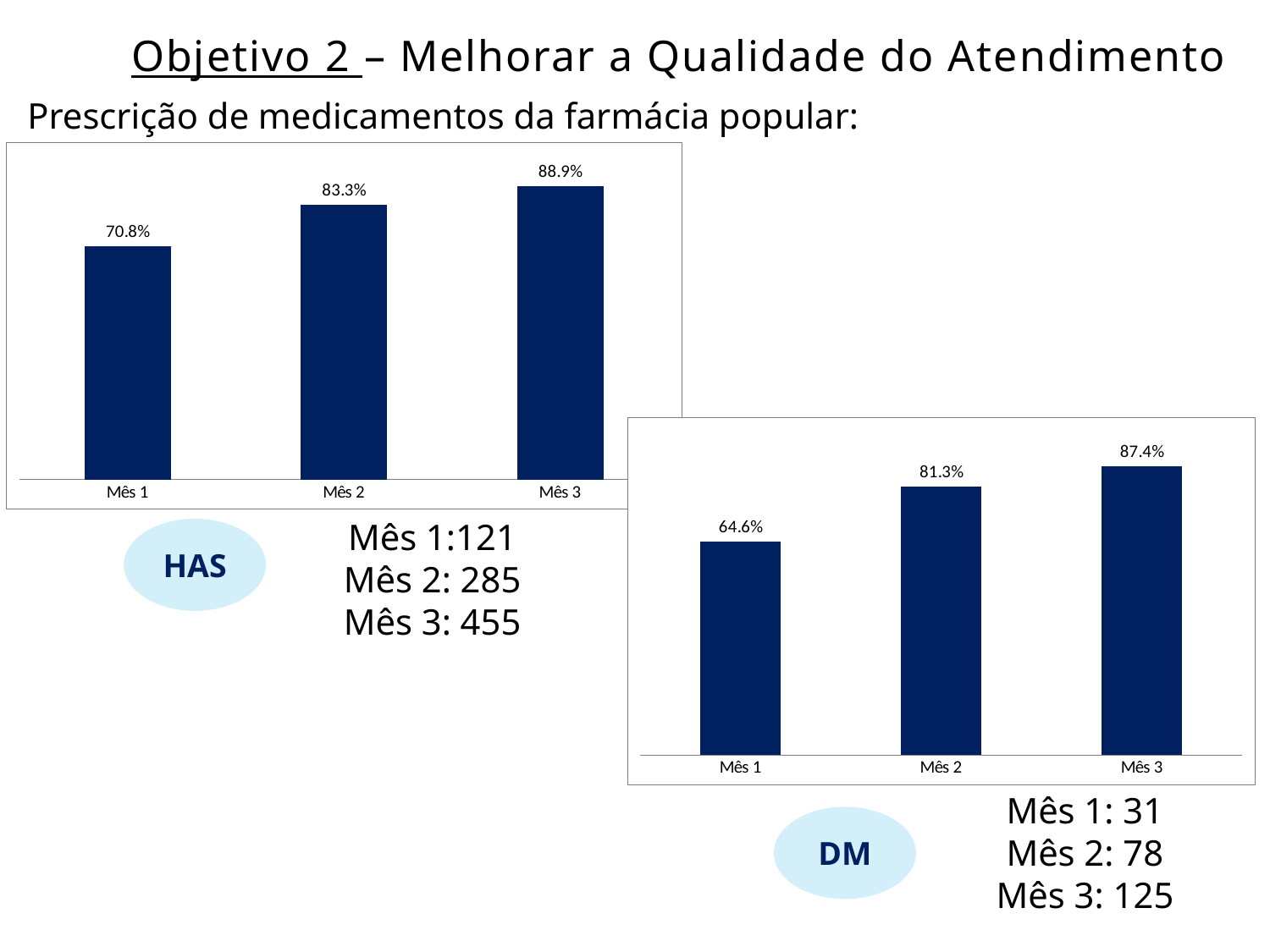
In the top-left chart (HAS), which month has the highest value? Mês 3 Which is larger: the Mês 2 value in the top-left chart (HAS) or the Mês 2 value in the bottom-right chart (DM)? HAS (83.3%) In the top-left chart (HAS), what is the value for Mês 3? 88.9% In the bottom-right chart (DM), what is the difference between the values for Mês 2 and Mês 1? 16.7% What type of chart is the top-left chart (HAS)? Bar chart In the bottom-right chart (DM), what is the value for Mês 1? 64.6% In the bottom-right chart (DM), what is the value for Mês 2? 81.3% In the bottom-right chart (DM), do the values rise or fall from Mês 1 to Mês 3? Rise In the bottom-right chart (DM), which month has the lowest value? Mês 1 How many bars are shown in the bottom-right chart (DM)? 3 In the top-left chart (HAS), what is the difference between the values for Mês 3 and Mês 1? 18.1% In the top-left chart (HAS), what is the value for Mês 1? 70.8%